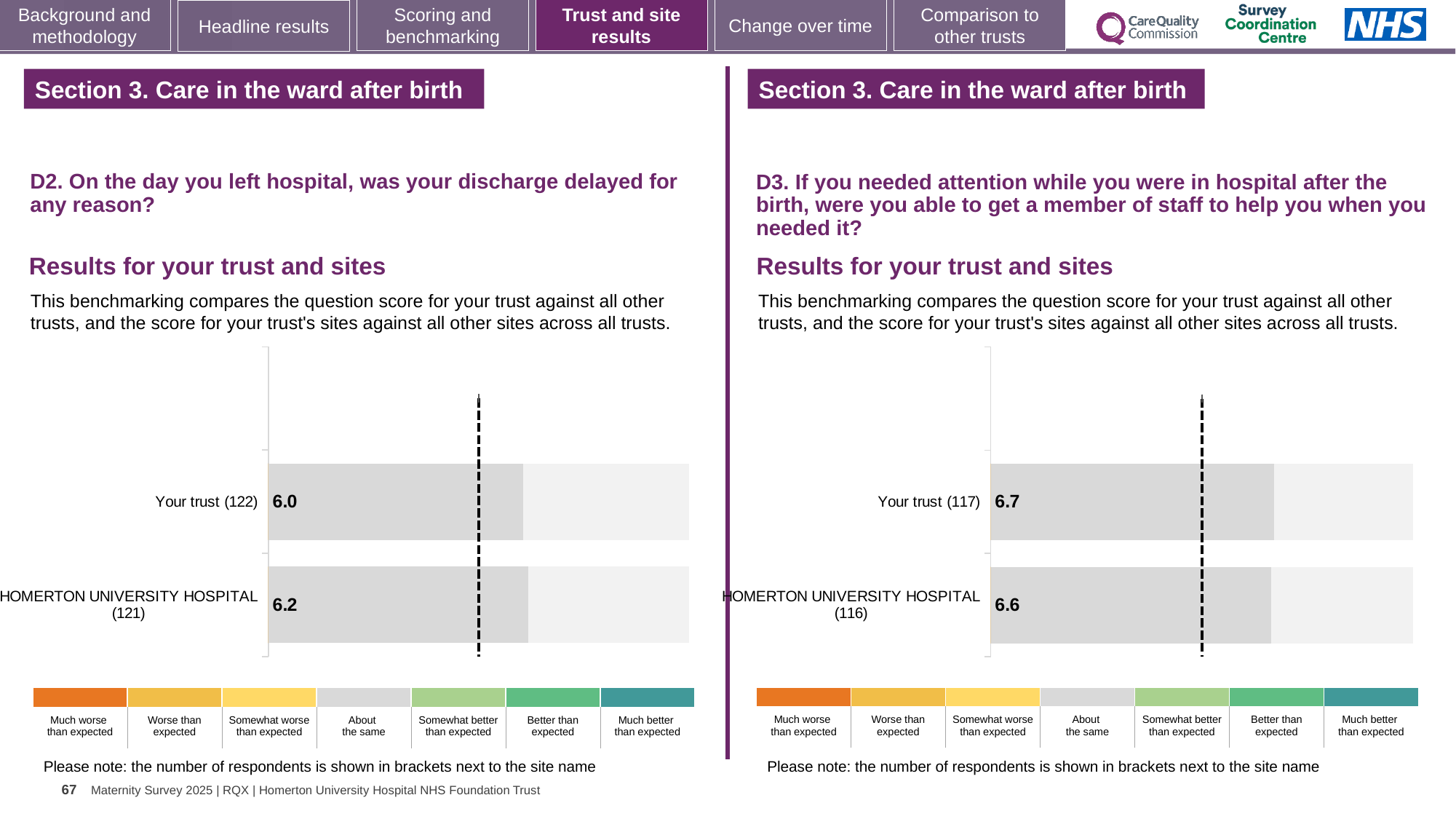
In the right chart (D3), how many respondents are shown in brackets for Your trust? 117 How many bars are plotted in the left chart (D2)? 2 In the right chart (D3, able to get a member of staff to help), what is the score for Homerton University Hospital? 6.6 In the left chart (D2), how many respondents are shown in brackets for Homerton University Hospital? 121 In the right chart (D3), which has the higher score, Your trust or Homerton University Hospital? Your trust In the left chart (D2, discharge delayed), what is the score for Your trust? 6.0 In the left chart (D2), what is the difference between the Homerton University Hospital score and the Your trust score? 0.2 What type of chart is used for the D3 results on the right? Bar chart In the left chart (D2, discharge delayed), what is the score for Homerton University Hospital? 6.2 In the right chart (D3, able to get a member of staff to help), what is the score for Your trust? 6.7 In the left chart (D2), which has the higher score, Your trust or Homerton University Hospital? Homerton University Hospital In the right chart (D3), what is the difference between the Your trust score and the Homerton University Hospital score? 0.1